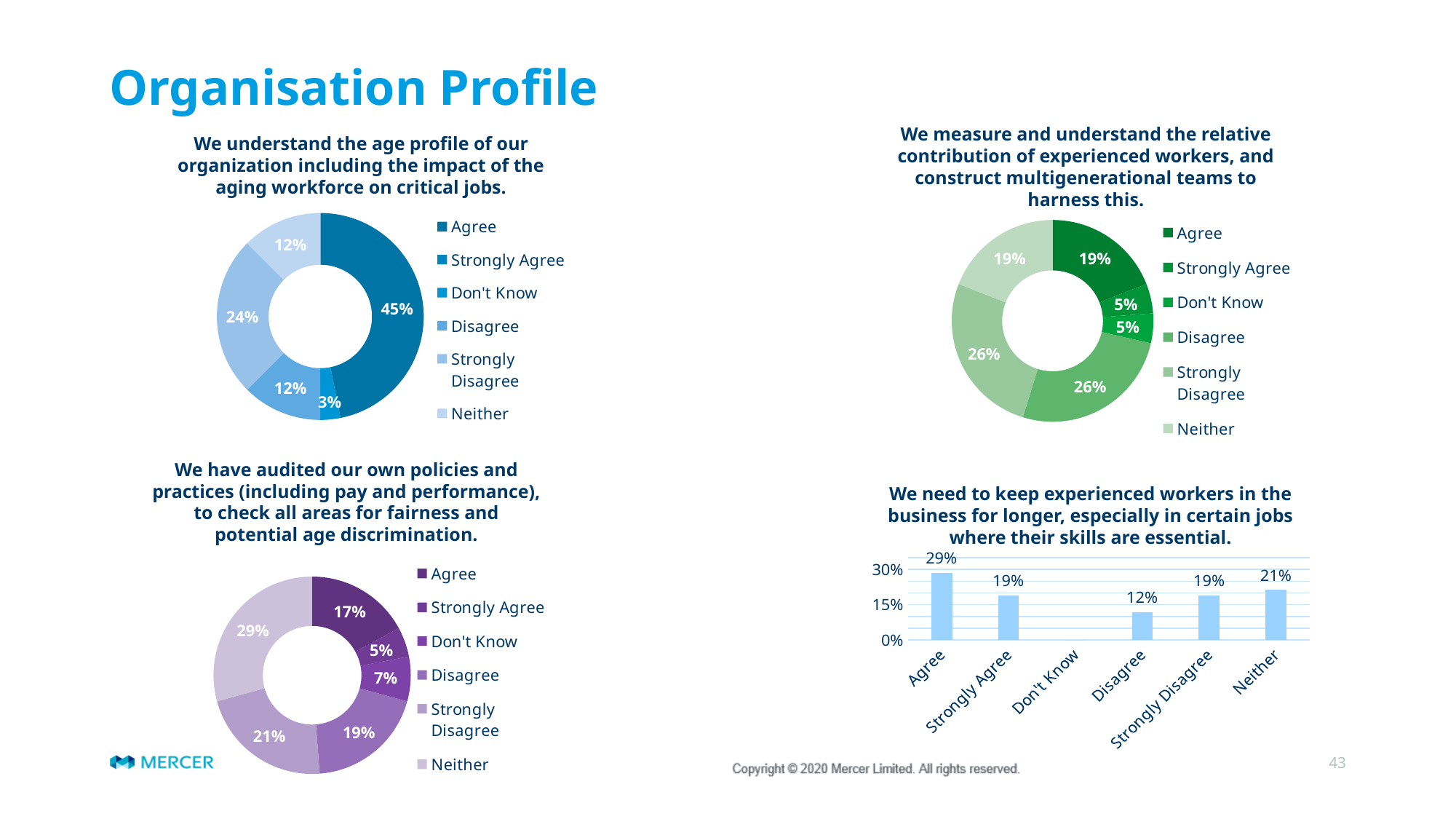
What kind of chart is the bottom-right chart titled 'We need to keep experienced workers in the business for longer...'? Bar chart How many entries does the legend of the top-right doughnut chart list? 6 How many categories are shown on the x axis of the bottom-right bar chart? 6 In the bottom-right bar chart, which category has the highest value? Agree In the bottom-right bar chart, what is the difference between the values for Agree and Disagree? 17% In the top-left doughnut chart ('We understand the age profile of our organization...'), what is the share for Agree? 45% In the top-right doughnut chart ('We measure and understand the relative contribution of experienced workers...'), what is the share for Neither? 19% In the top-left doughnut chart ('We understand the age profile of our organization...'), which is larger: Agree or Disagree? Agree In the bottom-left doughnut chart ('We have audited our own policies and practices...'), which category has the largest share? Neither In the bottom-right bar chart, what is the value for Agree? 29% In the top-right doughnut chart ('We measure and understand the relative contribution of experienced workers...'), what is the share for Disagree? 26% In the bottom-left doughnut chart ('We have audited our own policies and practices...'), what is the share for Agree? 17%